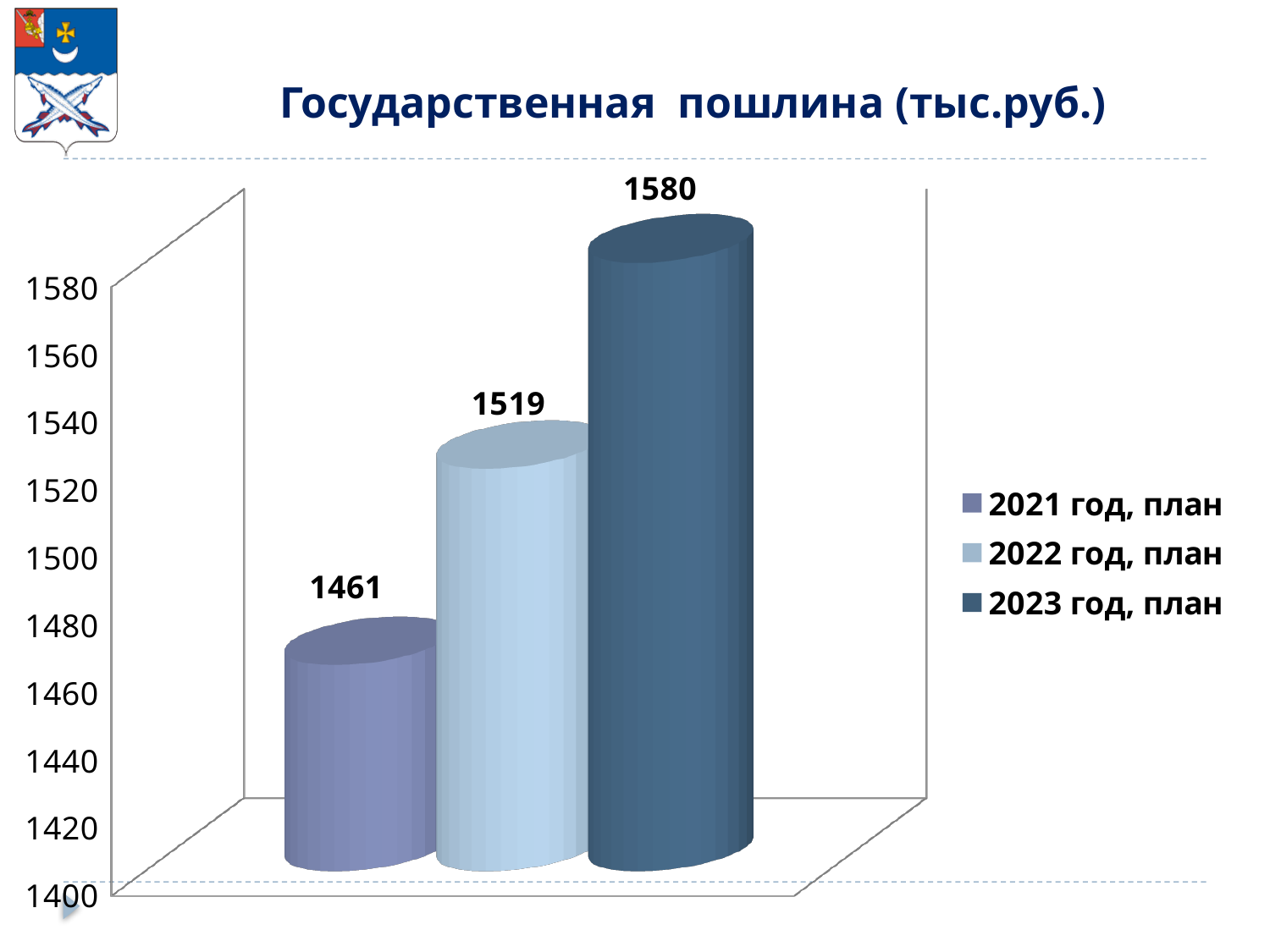
Which series has the lowest value? 2021 год, план What is the value for 2023 год, план? 1580 What is the value for 2021 год, план? 1461 How many series does the legend list? 3 What is the value for 2022 год, план? 1519 What is the title of the chart? Государственная пошлина (тыс.руб.) Which is larger, the value for 2022 год, план or the value for 2023 год, план? 2023 год, план What is the difference between the values for 2022 год, план and 2021 год, план? 58 Which series has the highest value? 2023 год, план What is the difference between the values for 2023 год, план and 2021 год, план? 119 What kind of chart is shown on the slide? bar chart Do the values rise or fall from 2021 to 2023? rise